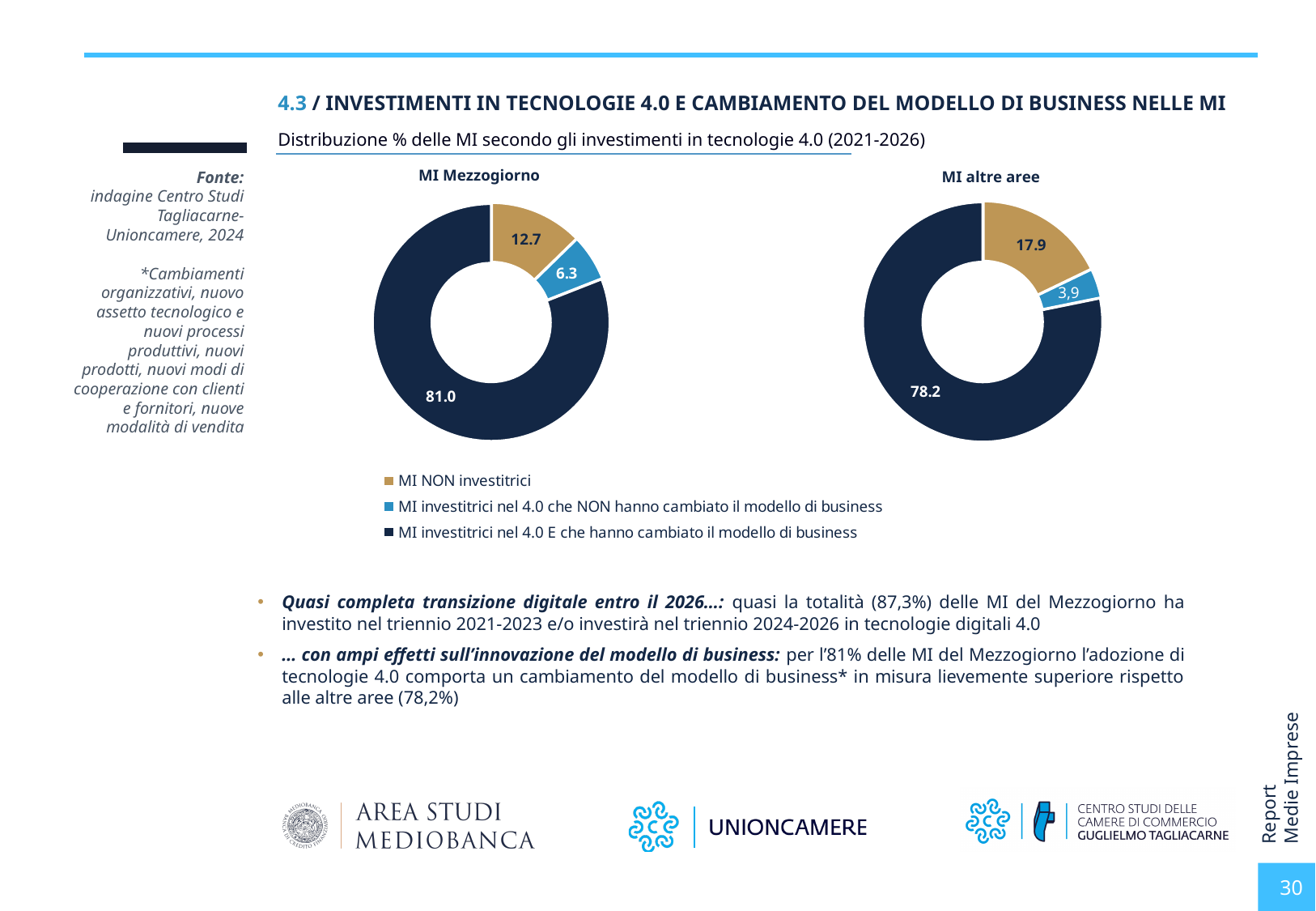
What type of chart is used for 'MI Mezzogiorno' and 'MI altre aree'? Donut (pie) chart In the 'MI Mezzogiorno' chart, which category has the largest share? MI investitrici nel 4.0 E che hanno cambiato il modello di business In the 'MI Mezzogiorno' chart, what is the value for 'MI NON investitrici'? 12.7 In the 'MI altre aree' chart, what is the value for 'MI investitrici nel 4.0 che NON hanno cambiato il modello di business'? 3,9 In the 'MI altre aree' chart, which category has the smallest share? MI investitrici nel 4.0 che NON hanno cambiato il modello di business In the 'MI altre aree' chart, what is the value for 'MI NON investitrici'? 17.9 Which colour represents 'MI NON investitrici' in the charts? Tan/gold How many categories does each donut chart show? 3 Which chart shows a larger value for 'MI investitrici nel 4.0 E che hanno cambiato il modello di business', 'MI Mezzogiorno' or 'MI altre aree'? MI Mezzogiorno How many entries does the legend list? 3 What is the difference between the 'MI NON investitrici' values in the 'MI altre aree' chart and the 'MI Mezzogiorno' chart? 5.2 In the 'MI Mezzogiorno' chart, what is the value for 'MI investitrici nel 4.0 E che hanno cambiato il modello di business'? 81.0